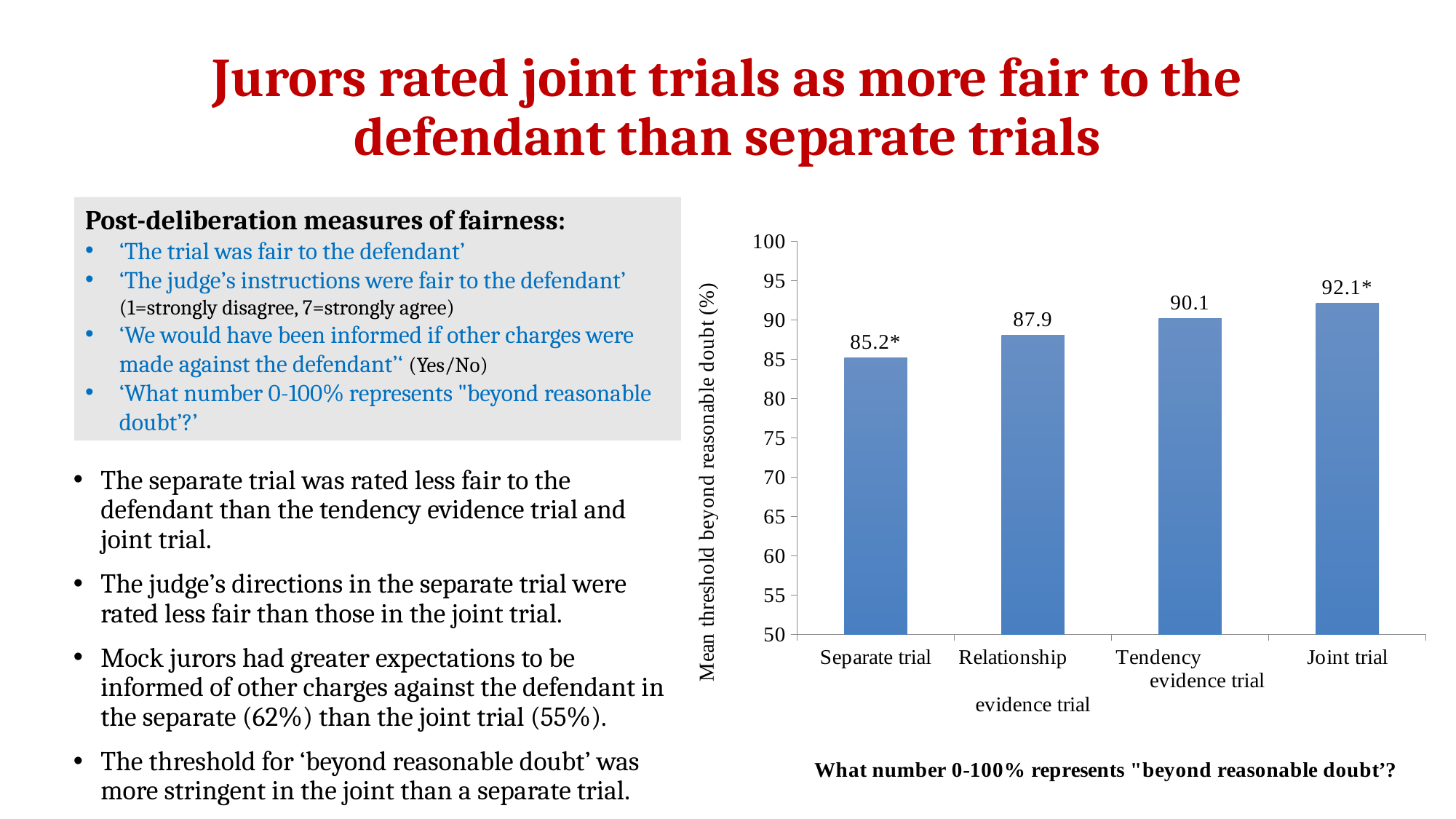
What is the label of the vertical axis of the chart? Mean threshold beyond reasonable doubt (%) Is the value for the Separate trial greater or less than 90? less What is the mean threshold beyond reasonable doubt for the Relationship evidence trial? 87.9 What is the mean threshold beyond reasonable doubt for the Joint trial? 92.1* What is the mean threshold beyond reasonable doubt for the Tendency evidence trial? 90.1 What kind of chart is shown on the slide? Bar chart What is the difference between the mean threshold for the Joint trial and the Separate trial? 6.9 Which trial type has the highest mean threshold beyond reasonable doubt? Joint trial Which trial type has the lowest mean threshold beyond reasonable doubt? Separate trial Which has a higher mean threshold beyond reasonable doubt, the Relationship evidence trial or the Tendency evidence trial? Tendency evidence trial How many trial types are shown on the chart? 4 What is the mean threshold beyond reasonable doubt for the Separate trial? 85.2*